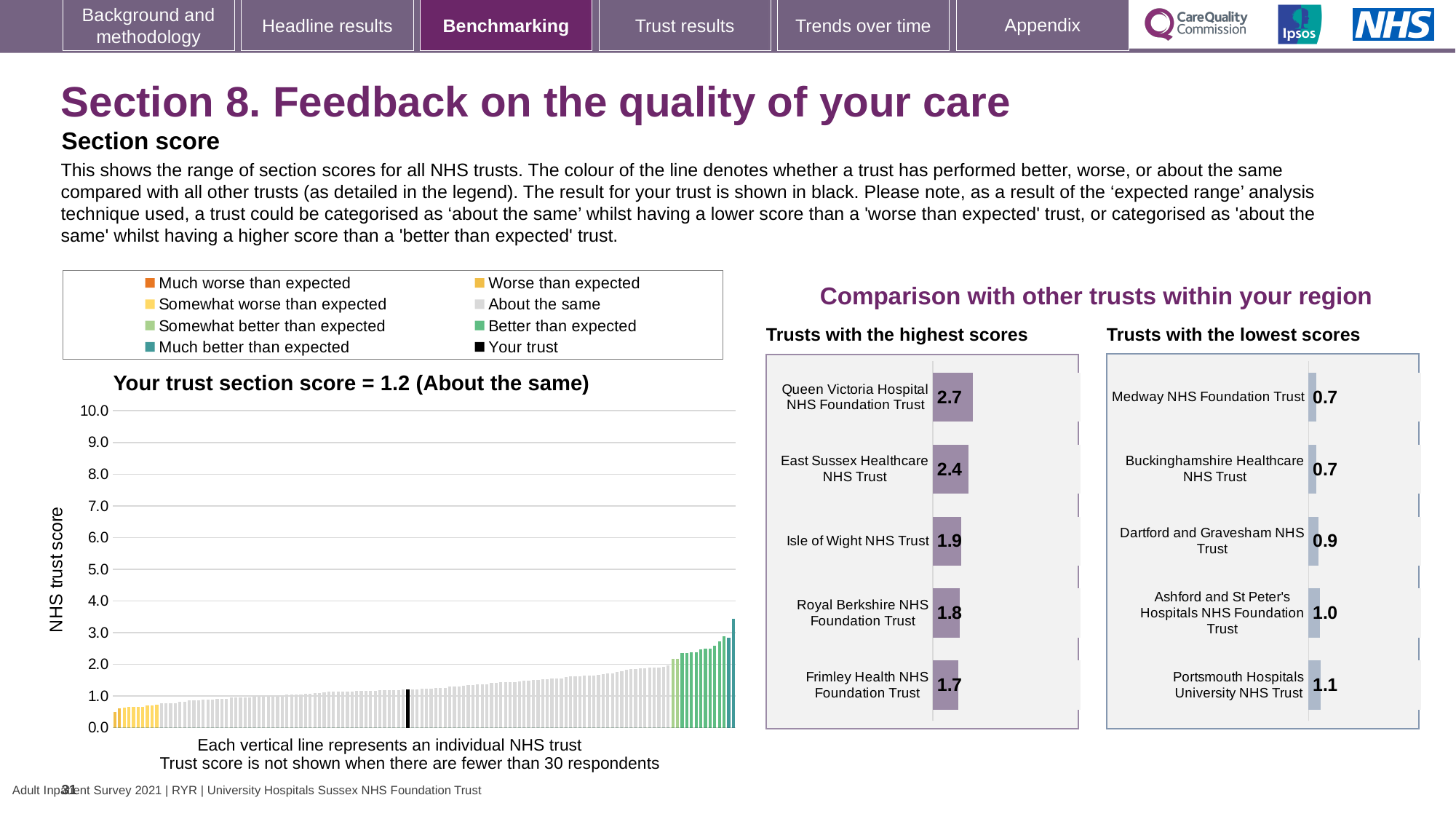
In the 'Trusts with the lowest scores' chart, what is the score for Dartford and Gravesham NHS Trust? 0.9 In the 'Trusts with the highest scores' chart, how many trusts are shown? 5 In the 'Trusts with the highest scores' chart, what is the difference between the scores of Queen Victoria Hospital NHS Foundation Trust and Frimley Health NHS Foundation Trust? 1.0 In the 'Trusts with the lowest scores' chart, which trust has the highest score? Portsmouth Hospitals University NHS Trust What kind of chart is the 'Your trust section score' chart? Bar chart In the 'Your trust section score' chart, how many entries does the legend list? 8 In the 'Your trust section score' chart, what is the highest value shown on the y axis? 10.0 In the 'Trusts with the highest scores' chart, what is the score for Queen Victoria Hospital NHS Foundation Trust? 2.7 In the 'Trusts with the lowest scores' chart, which is larger: the score for Ashford and St Peter's Hospitals NHS Foundation Trust or the score for Medway NHS Foundation Trust? Ashford and St Peter's Hospitals NHS Foundation Trust In the 'Your trust section score' chart, do the trust scores rise or fall from left to right? Rise In the 'Trusts with the highest scores' chart, which trust has the lowest score? Frimley Health NHS Foundation Trust In the 'Your trust section score' chart, what is the section score for your trust? 1.2